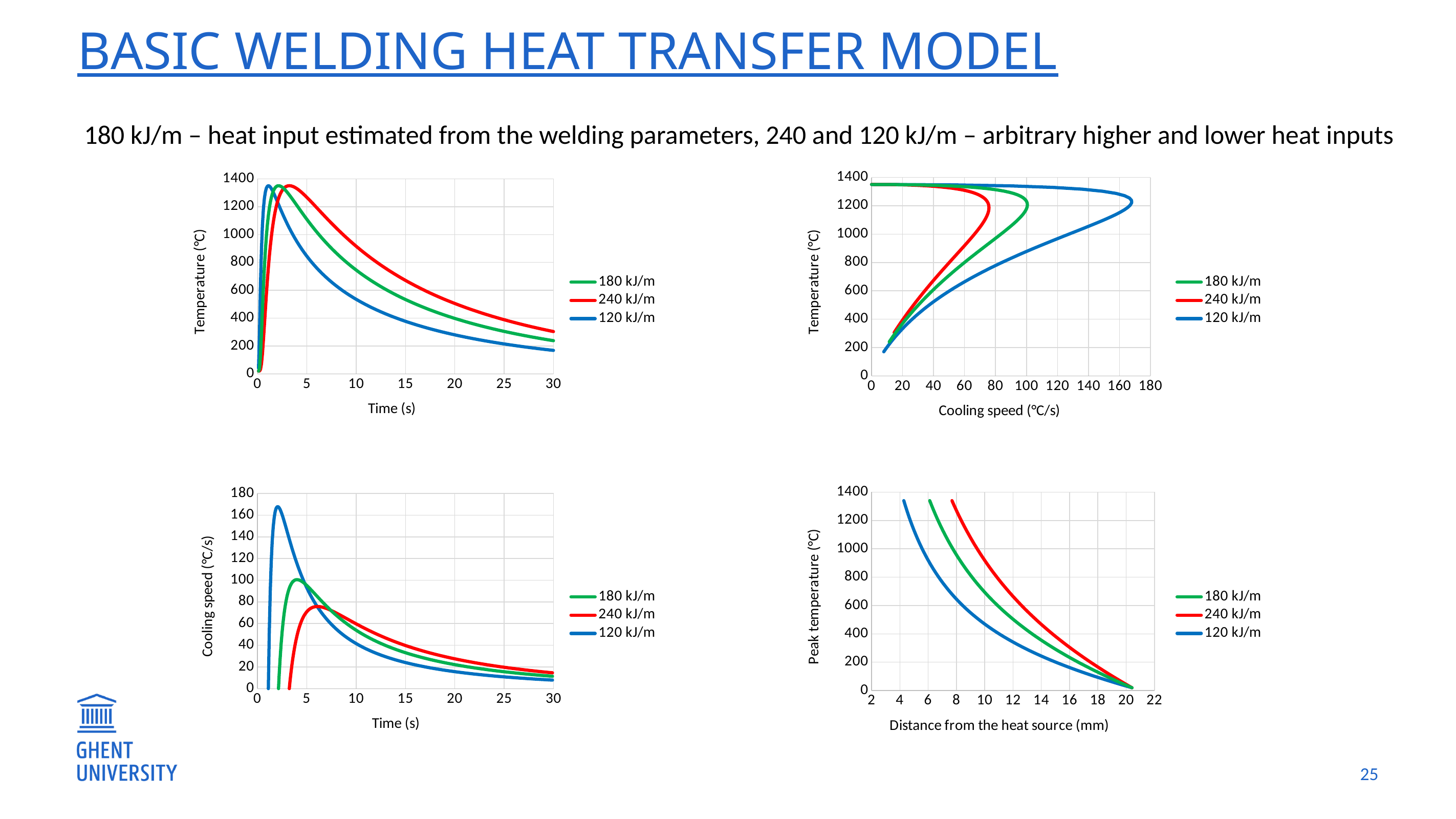
In the bottom-left chart (Cooling speed vs Time), which series has the highest peak cooling speed? 120 kJ/m In the bottom-right chart (Peak temperature vs Distance), is the peak temperature of the 120 kJ/m series at 10 mm greater or less than 600? less In the top-left chart (Temperature vs Time), which series reaches its peak temperature earliest? 120 kJ/m What kind of chart is the top-left chart (Temperature vs Time)? line chart In the top-right chart (Temperature vs Cooling speed), which series reaches the highest cooling speed? 120 kJ/m In the bottom-left chart (Cooling speed vs Time), is the peak cooling speed of the 120 kJ/m series greater or less than 140? greater In the bottom-right chart (Peak temperature vs Distance), do the peak temperatures rise or fall as distance from the heat source increases? fall In the bottom-left chart (Cooling speed vs Time), is the peak cooling speed of the 240 kJ/m series greater or less than 100? less What is the x-axis title of the bottom-right chart? Distance from the heat source (mm) How many series does the legend of the top-left chart (Temperature vs Time) list? 3 In the top-left chart (Temperature vs Time), which series has the lowest temperature at 30 s? 120 kJ/m